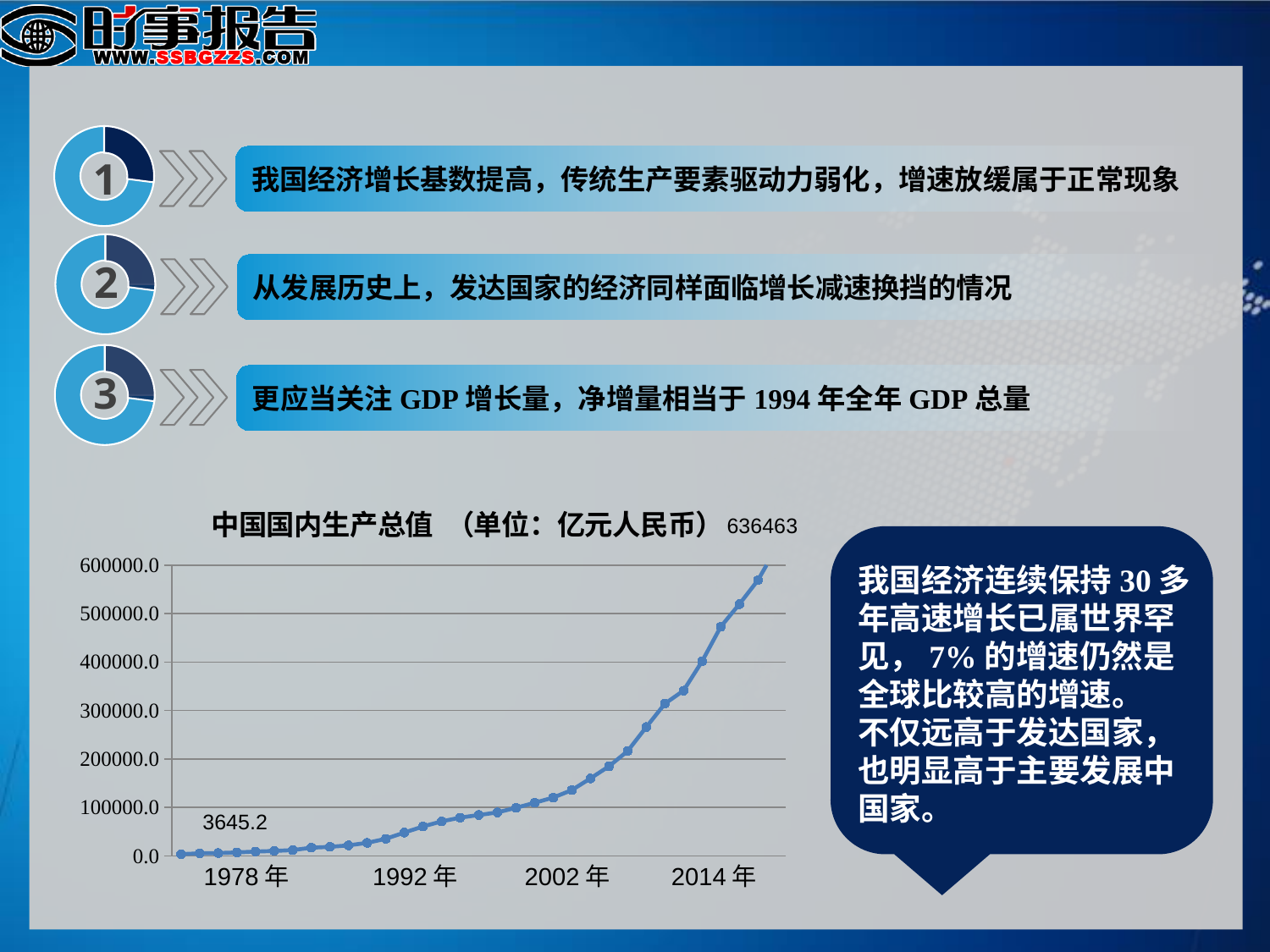
Which year has the highest value on the chart? 2014年 Which is larger, the value for 1978年 or the value for 2014年? 2014年 What is the highest tick value shown on the vertical axis of the chart? 600000.0 Is the value for 2002年 greater or less than 200000.0? less Do the values on the chart rise or fall from 1978年 to 2014年? rise What is the GDP value labelled for 2014年 on the chart? 636463 What is the title of the chart? 中国国内生产总值 （单位：亿元人民币） Is the value for 1992年 greater or less than 100000.0? less What is the GDP value labelled for 1978年 on the chart? 3645.2 What is the difference between the labelled values for 2014年 and 1978年? 632817.8 What kind of chart is shown on the slide? line chart Which year has the lowest value on the chart? 1978年